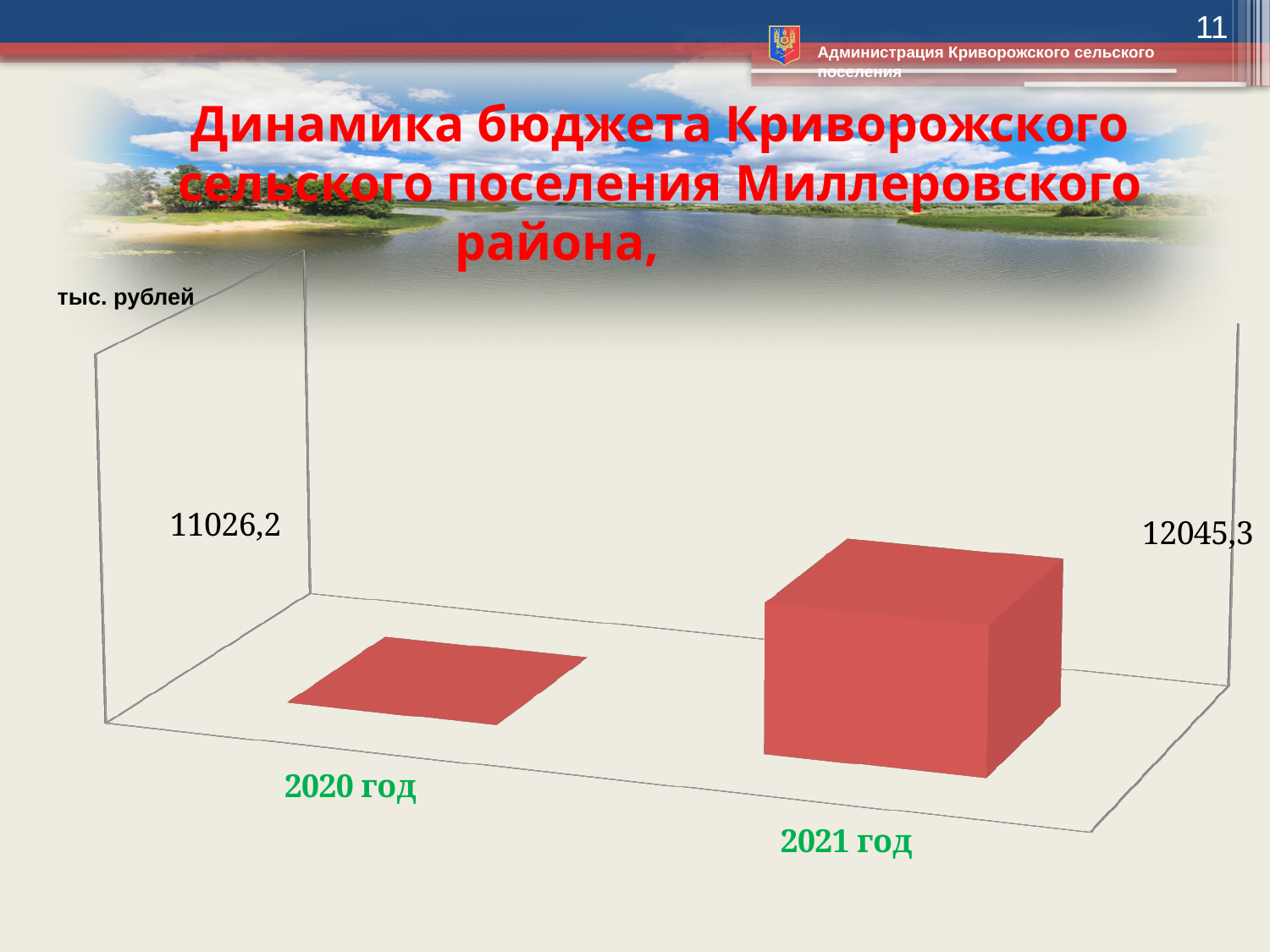
Does the budget value rise or fall from 2020 год to 2021 год? rise What is the budget value shown for 2020 год? 11026,2 What is the budget value shown for 2021 год? 12045,3 Which year has the higher budget value? 2021 год What colour are the bars in the chart? red Is the value for 2021 год larger or smaller than the value for 2020 год? larger How many years (categories) are shown in the chart? 2 What kind of chart is shown on the slide? bar chart In what units are the chart values given? тыс. рублей By how much does the 2021 год value exceed the 2020 год value? 1019,1 Which year has the lower budget value? 2020 год